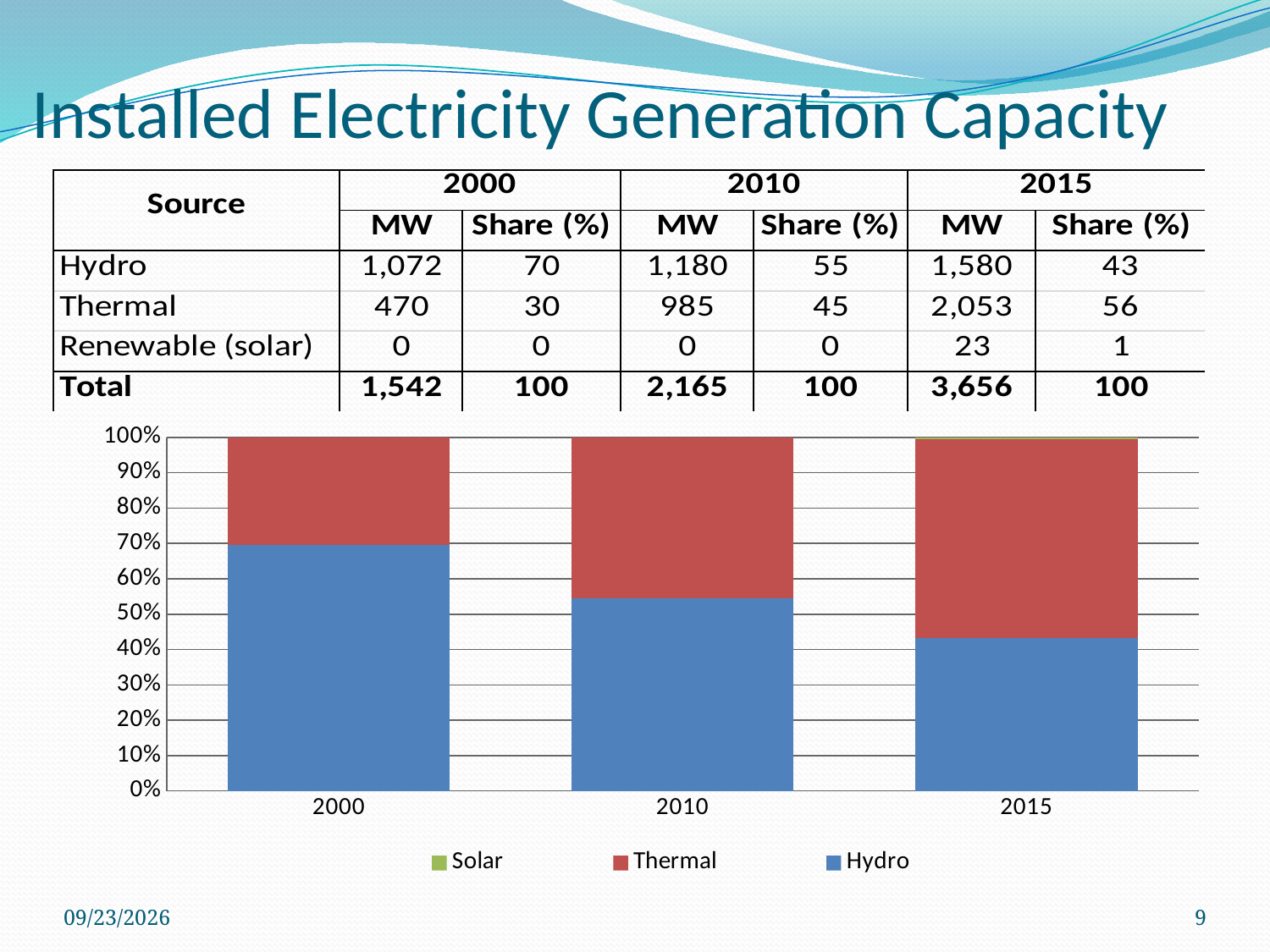
Which series is shown at the bottom of each stacked bar? Hydro How many series does the chart legend list? 3 Does the Hydro share rise or fall from 2000 to 2015 in the chart? fall In 2015, which has the larger share in the chart, Hydro or Thermal? Thermal Is the Hydro share for 2000 in the chart greater or less than 60%? greater Which year has the highest Hydro share in the chart? 2000 Which year has the lowest Hydro share in the chart? 2015 How many years are shown along the x axis of the chart? 3 Is the Hydro share for 2015 in the chart greater or less than 50%? less In 2000, which has the larger share in the chart, Hydro or Thermal? Hydro What kind of chart is shown on the slide? bar chart Is the Thermal share for 2010 in the chart greater or less than 40%? greater